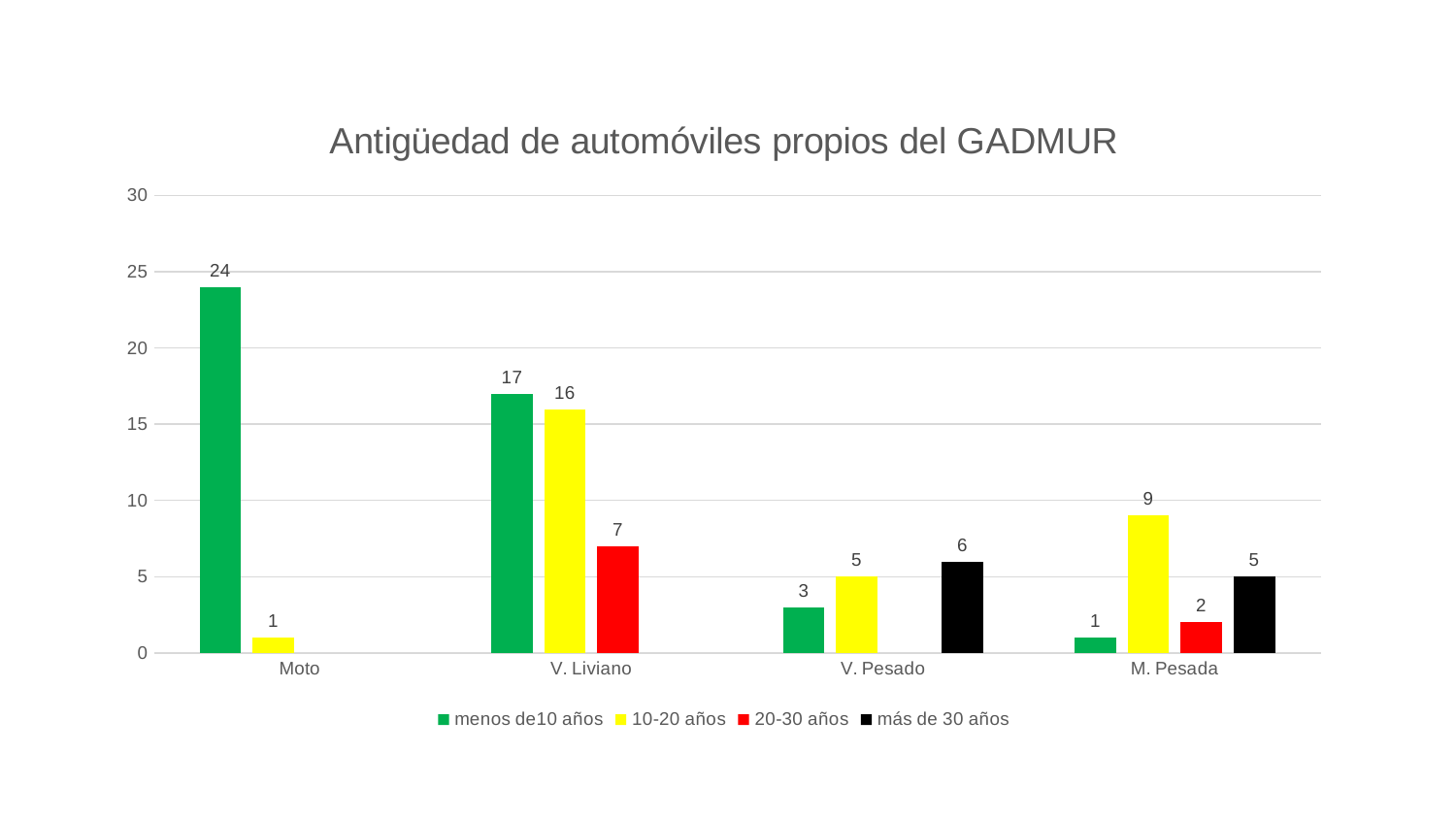
What is the value for '10-20 años' in the V. Liviano category? 16 What is the difference between the 'menos de10 años' and '10-20 años' values for V. Liviano? 1 How many series does the legend list? 4 How many categories are shown on the x axis? 4 Which category has the lowest value for '10-20 años'? Moto What is the value for 'menos de10 años' in the Moto category? 24 What is the title of the chart? Antigüedad de automóviles propios del GADMUR What kind of chart is shown on the slide? Bar chart Which is larger for M. Pesada: '10-20 años' or 'más de 30 años'? 10-20 años Which category has the highest value for 'menos de10 años'? Moto What is the value for 'más de 30 años' in the V. Pesado category? 6 What is the value for '20-30 años' in the M. Pesada category? 2